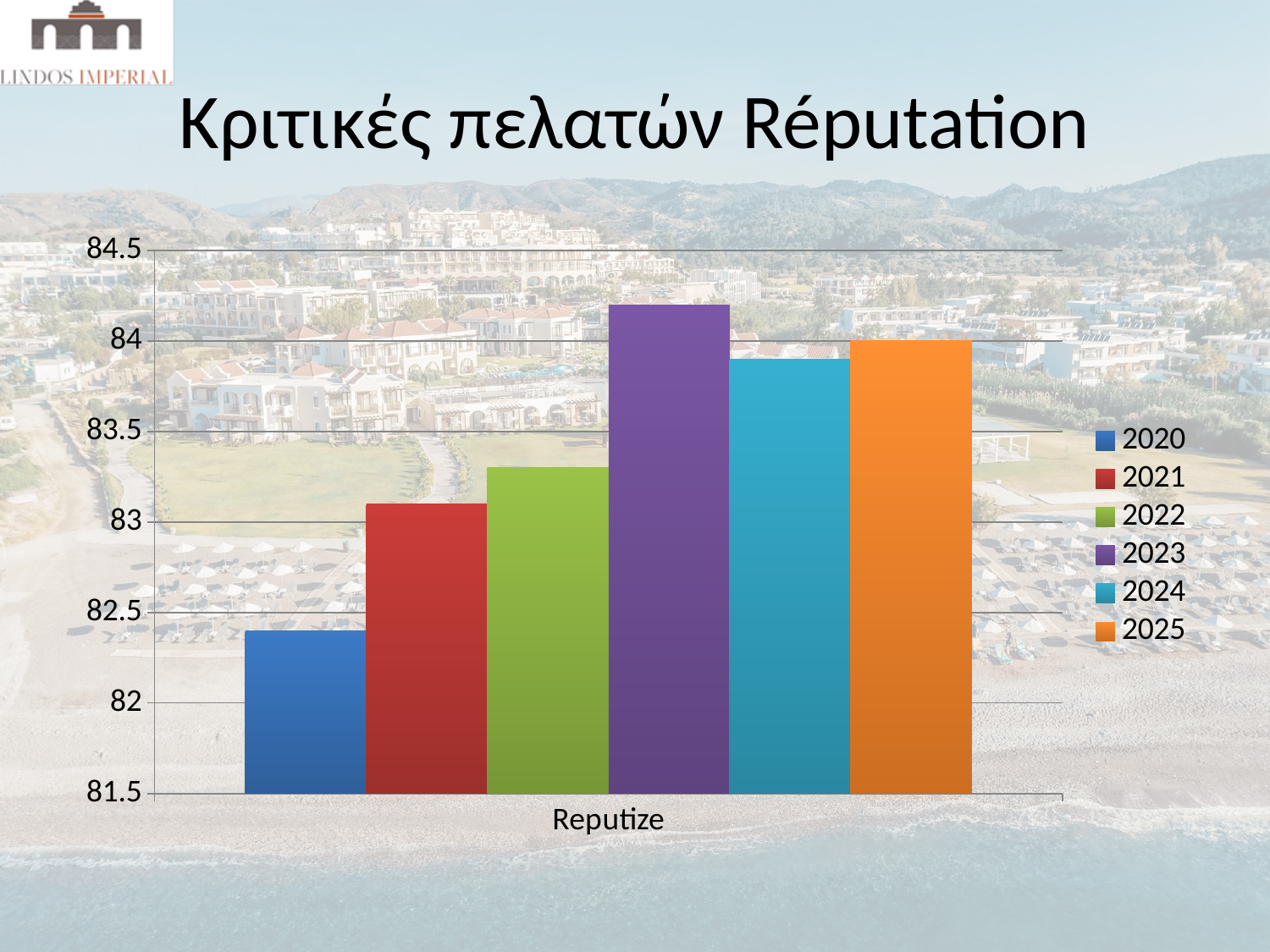
What kind of chart is shown on the slide? bar chart Is the value for 2020 greater or less than 82.5? less What is the category label shown on the x axis? Reputize How many categories are shown on the x axis? 1 Which year has the highest bar? 2023 Is the value for 2023 greater or less than 84? greater Which year has the lowest bar? 2020 Is the value for 2024 greater or less than 84? less How many series does the legend list? 6 Which is larger, the value for 2022 or the value for 2021? 2022 Do the bars rise or fall from 2020 to 2023? rise